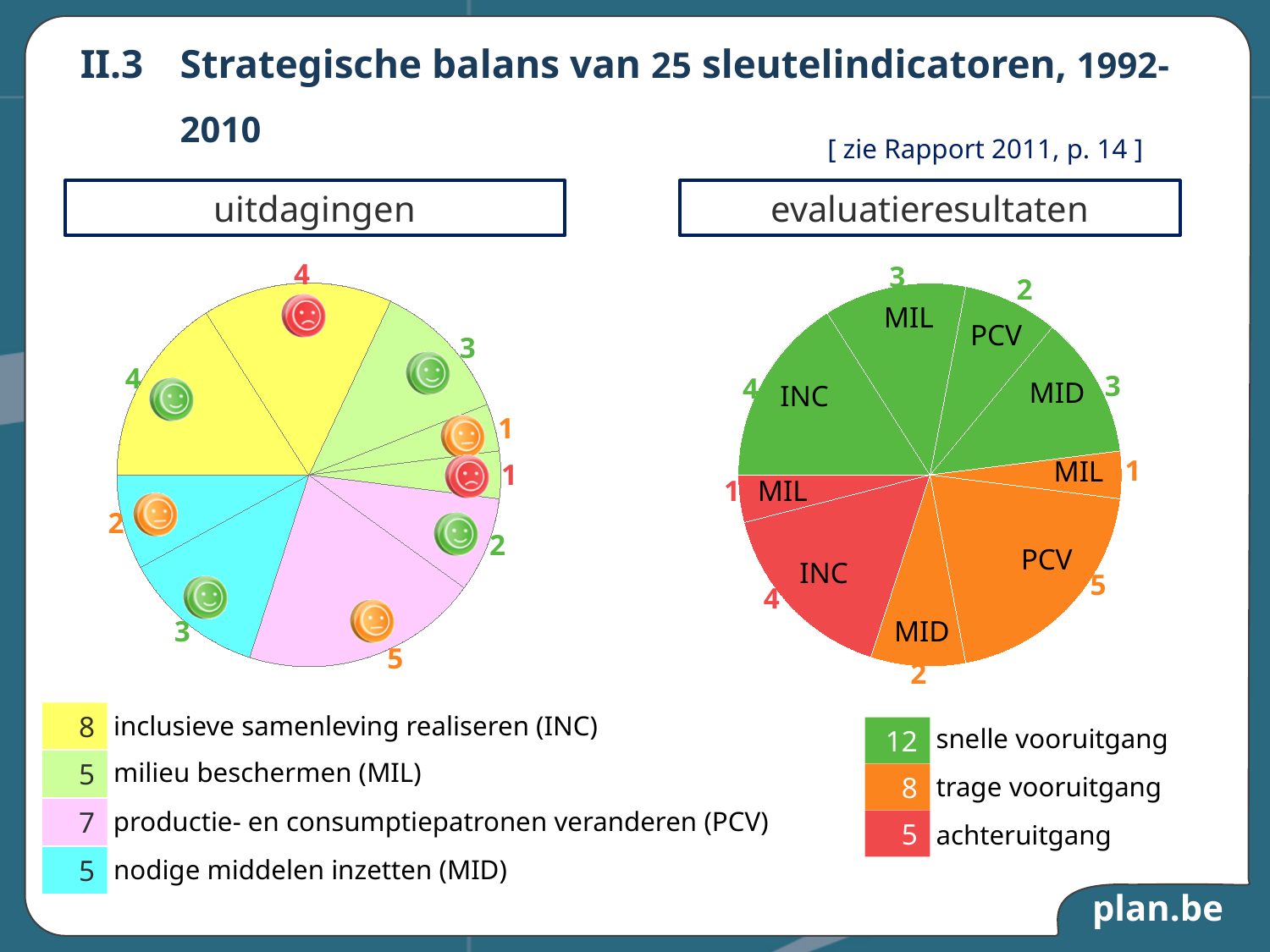
In the 'evaluatieresultaten' chart, how many indicators show 'achteruitgang'? 5 In the 'uitdagingen' chart, how many indicators belong to 'inclusieve samenleving realiseren (INC)'? 8 In the 'uitdagingen' chart, which challenge has the most indicators? inclusieve samenleving realiseren (INC) What kind of chart is used on the slide for 'uitdagingen' and 'evaluatieresultaten'? pie chart How many evaluation categories does the legend of the 'evaluatieresultaten' chart list? 3 In the 'evaluatieresultaten' chart, how many PCV indicators fall under 'trage vooruitgang' (orange)? 5 In the 'evaluatieresultaten' chart, how many INC indicators fall under 'achteruitgang' (red)? 4 In the 'evaluatieresultaten' chart, which evaluation category has the most indicators? snelle vooruitgang In the 'evaluatieresultaten' chart, what is the difference between the number of indicators with 'snelle vooruitgang' and those with 'achteruitgang'? 7 In the 'uitdagingen' chart, which has more indicators: PCV or MID? PCV In the 'evaluatieresultaten' chart, how many indicators show 'snelle vooruitgang'? 12 In the 'evaluatieresultaten' chart, how many indicators show 'trage vooruitgang'? 8